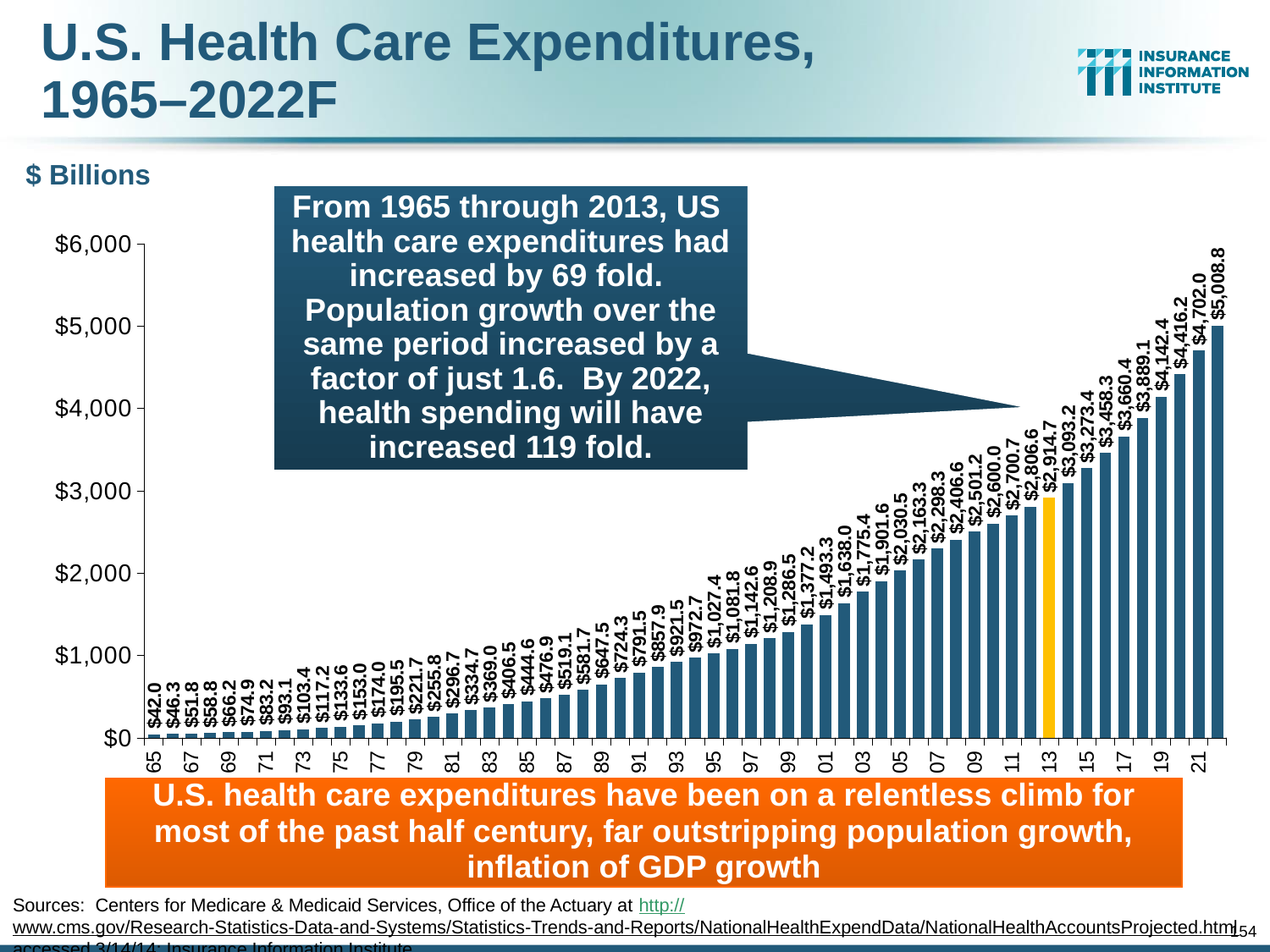
What is the highest value shown on the chart? $5,008.8 What type of chart is shown on the slide? Bar chart Do the values generally rise or fall from left to right along the x axis? Rise What is the value shown for 2010? $2,600.0 What is the difference between the 2022F value and the 2013 value? $2,094.1 What is the value shown for the last bar, 2022F? $5,008.8 Which year has the lowest health care expenditures on the chart? 1965 Which is larger, the value for 2013 or the value for 2010? 2013 What is the value of U.S. health care expenditures for 2013 (the highlighted bar)? $2,914.7 What is the value shown for the first bar, 1965? $42.0 How many bars (years) are plotted on the chart? 58 Which year's bar is highlighted in yellow? 2013